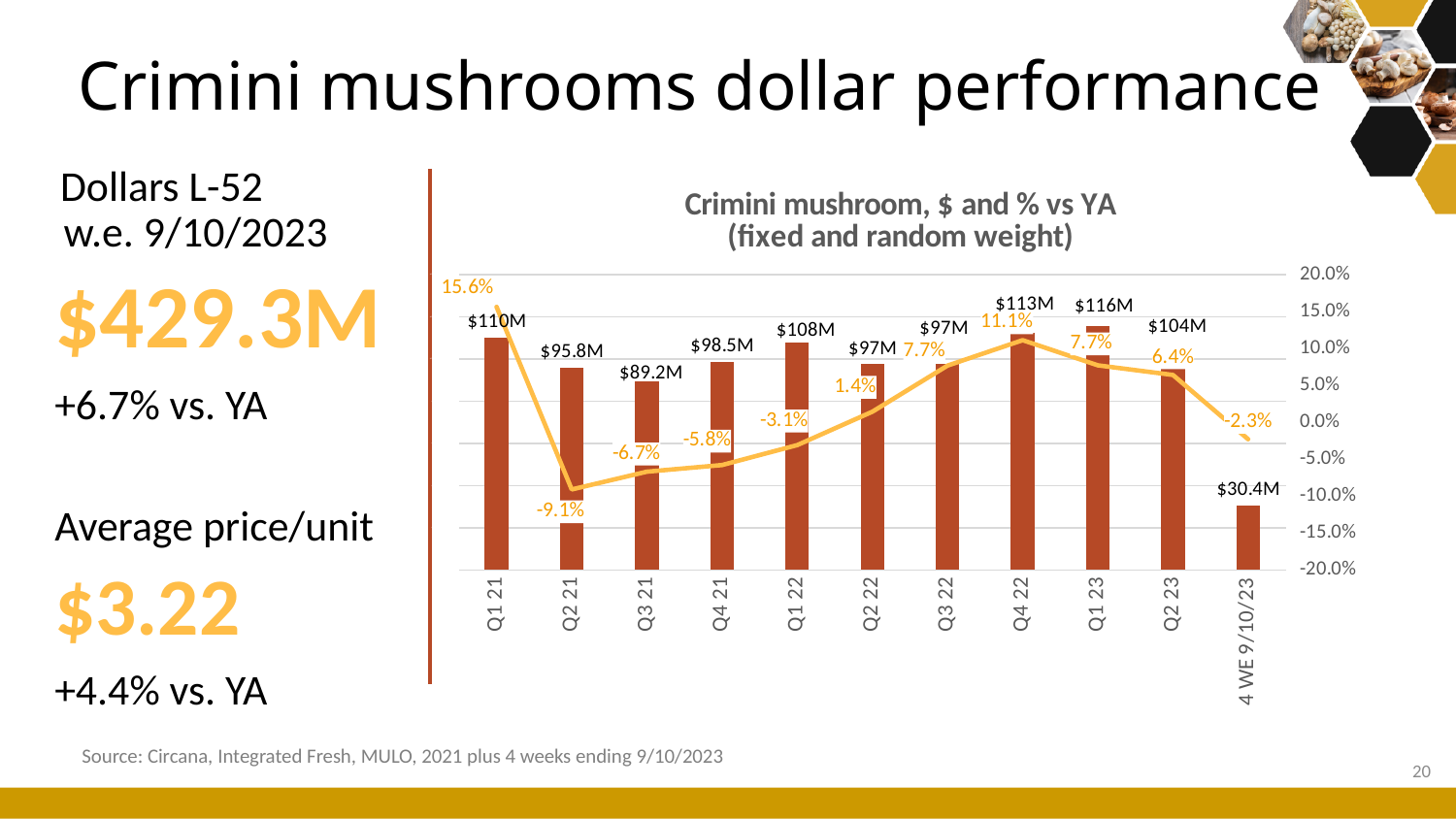
What is the dollar value shown for Q4 22? $113M What is the % vs YA value shown for the 4 WE 9/10/23 period? -2.3% Which has the larger dollar value, Q4 21 or Q1 22? Q1 22 Does the % vs YA line rise or fall from Q2 21 to Q4 22? Rises Which period has the highest % vs YA value on the line? Q1 21 What is the % vs YA value shown for Q2 21? -9.1% Which period has the lowest % vs YA value on the line? Q2 21 Which period has the lowest dollar bar? 4 WE 9/10/23 How many periods are shown on the x axis? 11 What kind of chart is this? Combination bar and line chart What is the difference in dollars between Q1 23 and Q2 23? $12M Which period has the highest dollar bar? Q1 23